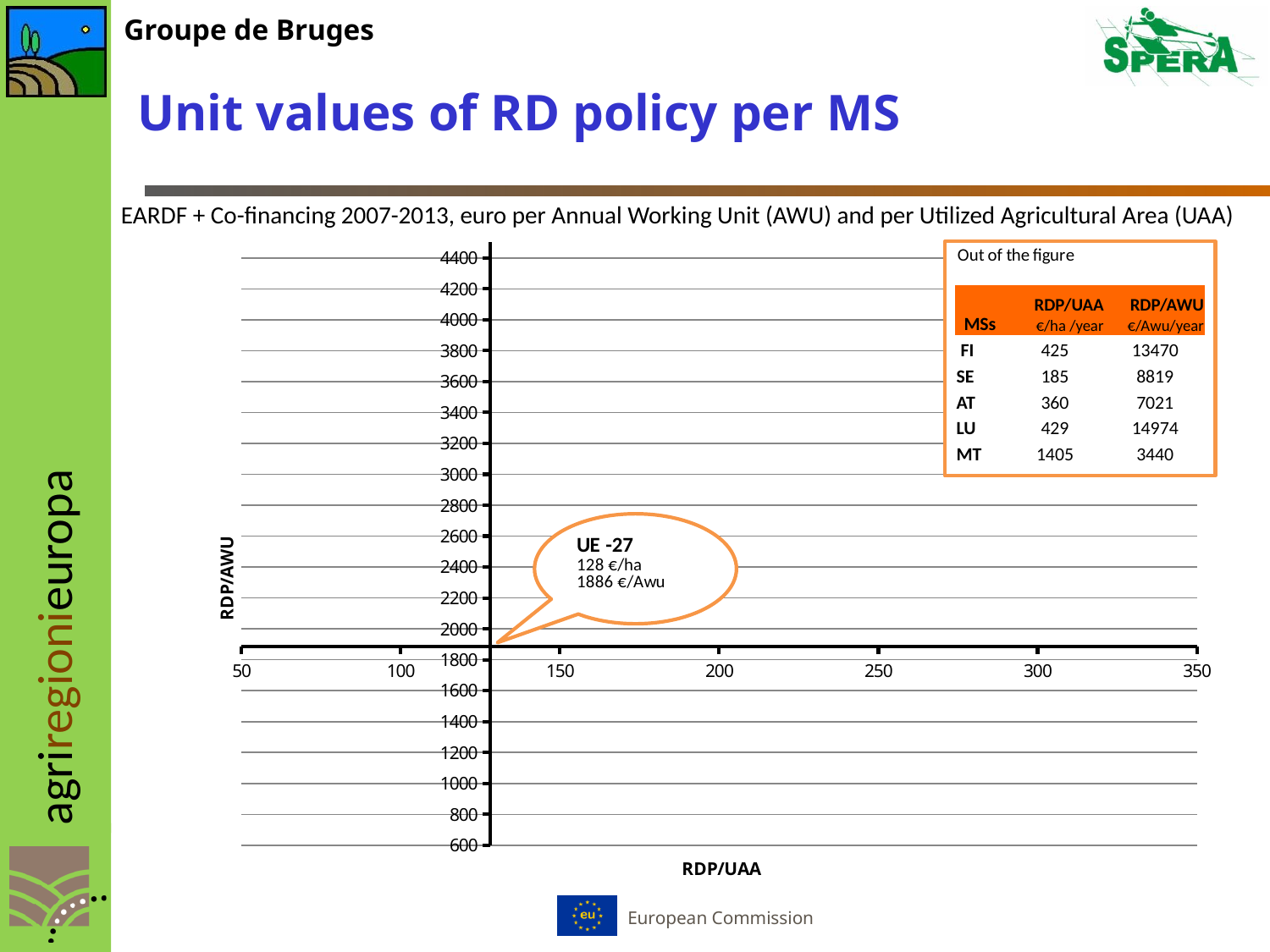
How many member states are listed in the 'Out of the figure' table? 5 Which member state in the 'Out of the figure' table has the highest RDP/AWU value? LU Which member state in the 'Out of the figure' table has the highest RDP/UAA value? MT According to the callout on the chart, what is the RDP/AWU value for UE-27? 1886 €/Awu In the 'Out of the figure' table, what is the RDP/UAA value for FI? 425 In the 'Out of the figure' table, what is the RDP/AWU value for LU? 14974 In the 'Out of the figure' table, what is the RDP/AWU value for SE? 8819 What is the label of the vertical axis of the chart? RDP/AWU According to the callout on the chart, what is the RDP/UAA value for UE-27? 128 €/ha Which member state in the 'Out of the figure' table has the lowest RDP/AWU value? MT What is the difference between the RDP/AWU values of LU and FI in the 'Out of the figure' table? 1504 What is the label of the horizontal axis of the chart? RDP/UAA